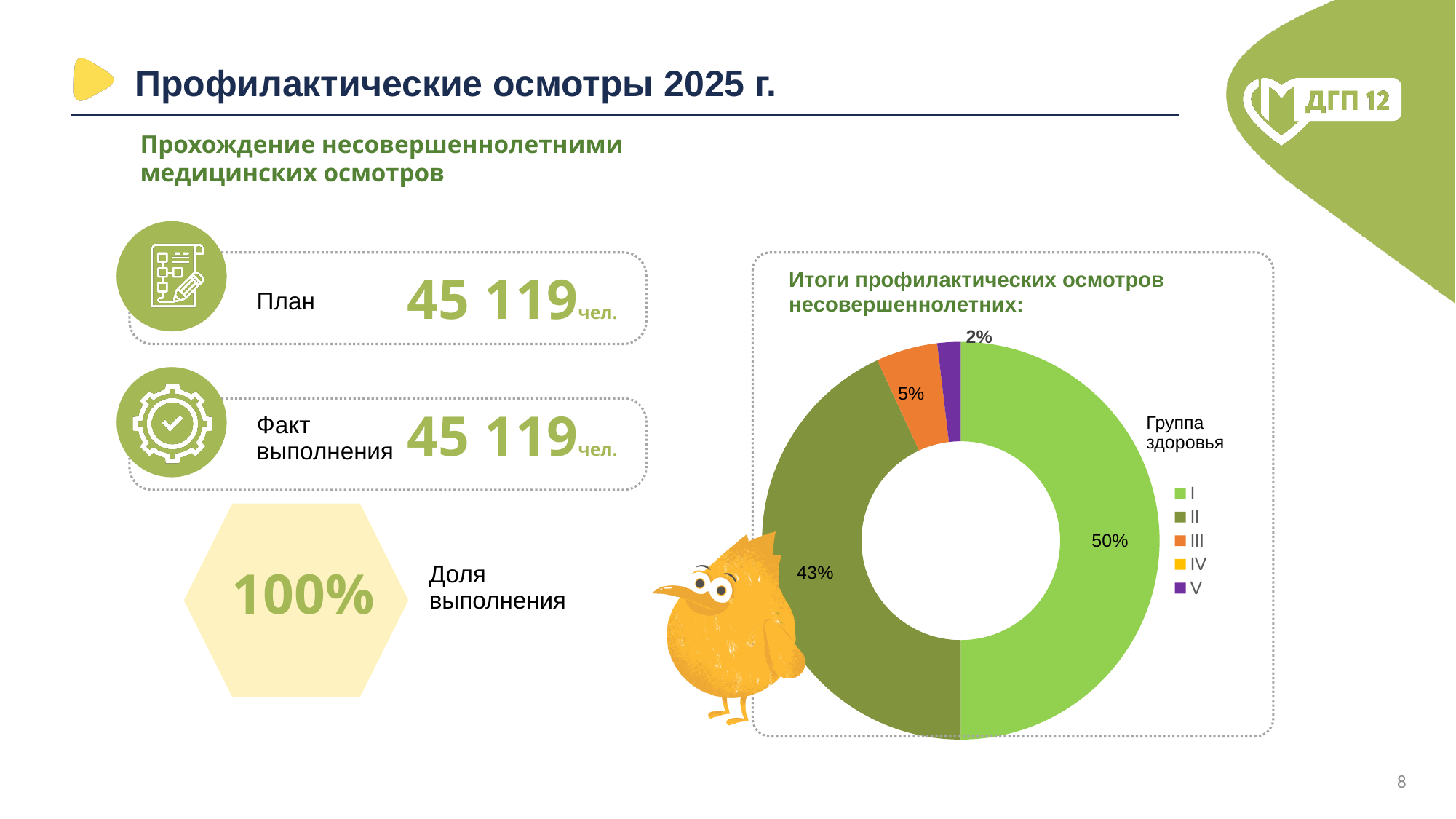
What is the combined share of health groups I and II in the doughnut chart? 93% What share of the doughnut chart is health group III? 5% What share of the doughnut chart is health group I (Группа здоровья I)? 50% Which health group has the largest share in the doughnut chart? I What share of the doughnut chart is health group V? 2% What is the difference in percentage points between health group I and health group II in the doughnut chart? 7 What is the title of the chart on the slide? Итоги профилактических осмотров несовершеннолетних: What type of chart is shown on the right side of the slide? Doughnut (pie) chart What share of the doughnut chart is health group II? 43% How many health groups does the legend of the doughnut chart list? 5 Which is larger in the doughnut chart: the share of health group III or health group V? III Which of the labelled slices in the doughnut chart is the smallest? V (2%)